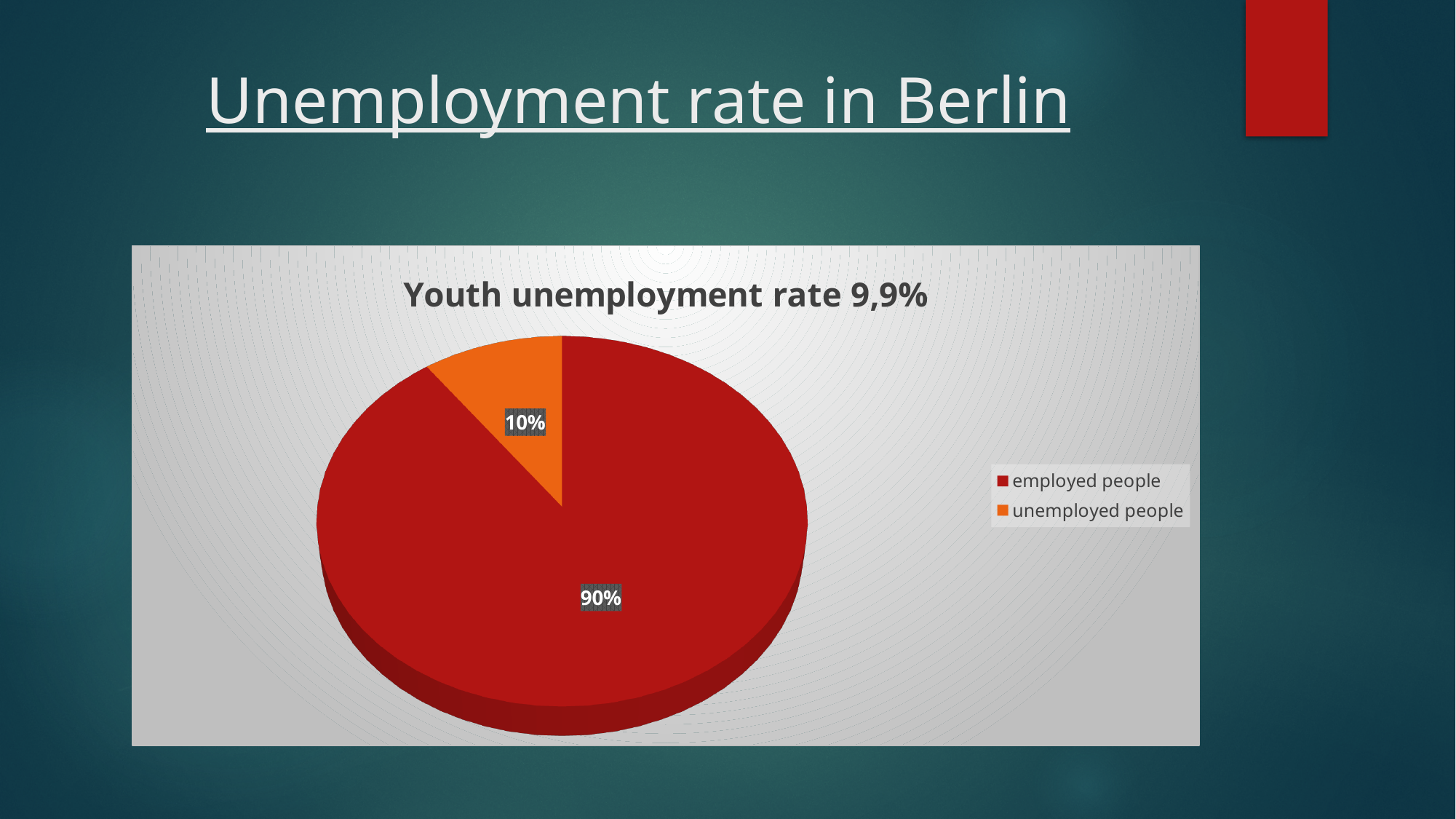
What kind of chart is shown on the slide? pie chart What colour is the slice for unemployed people? orange What share of the pie is labelled for employed people? 90% How many entries does the legend list? 2 Which slice is larger, employed people or unemployed people? employed people How many slices does the pie chart have? 2 Which slice of the pie is the smallest? unemployed people What is the difference in percentage points between the employed people slice and the unemployed people slice? 80 What is the title of the chart? Youth unemployment rate 9,9% Which slice of the pie is the largest? employed people What share of the pie is labelled for unemployed people? 10%